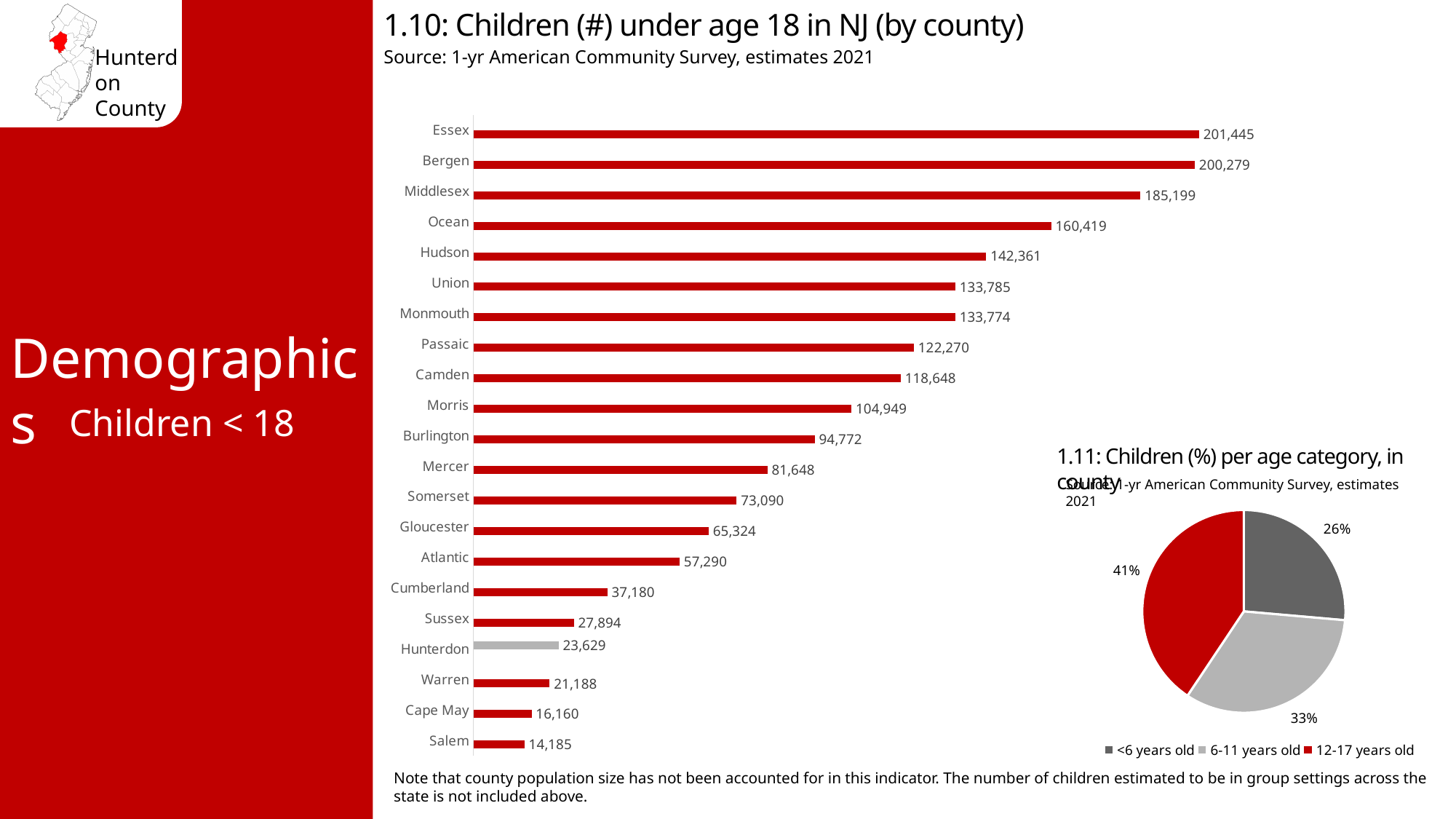
In the chart '1.10: Children (#) under age 18 in NJ (by county)', which county has the lowest value? Salem In the chart '1.10: Children (#) under age 18 in NJ (by county)', which county has the highest value? Essex In the chart '1.10: Children (#) under age 18 in NJ (by county)', how many counties are shown? 21 In the chart '1.10: Children (#) under age 18 in NJ (by county)', what is the value for Ocean? 160,419 In the chart '1.10: Children (#) under age 18 in NJ (by county)', what is the difference between the values for Essex and Bergen? 1,166 In the pie chart '1.11: Children (%) per age category, in county', which age category has the smallest share? <6 years old In the chart '1.10: Children (#) under age 18 in NJ (by county)', what is the value for Hunterdon? 23,629 What kind of chart is '1.10: Children (#) under age 18 in NJ (by county)'? Bar chart In the pie chart '1.11: Children (%) per age category, in county', what share is 12-17 years old? 41% In the chart '1.10: Children (#) under age 18 in NJ (by county)', which bar is coloured grey instead of red? Hunterdon How many categories does the legend of the pie chart '1.11: Children (%) per age category, in county' list? 3 In the chart '1.10: Children (#) under age 18 in NJ (by county)', which has a larger value, Morris or Burlington? Morris